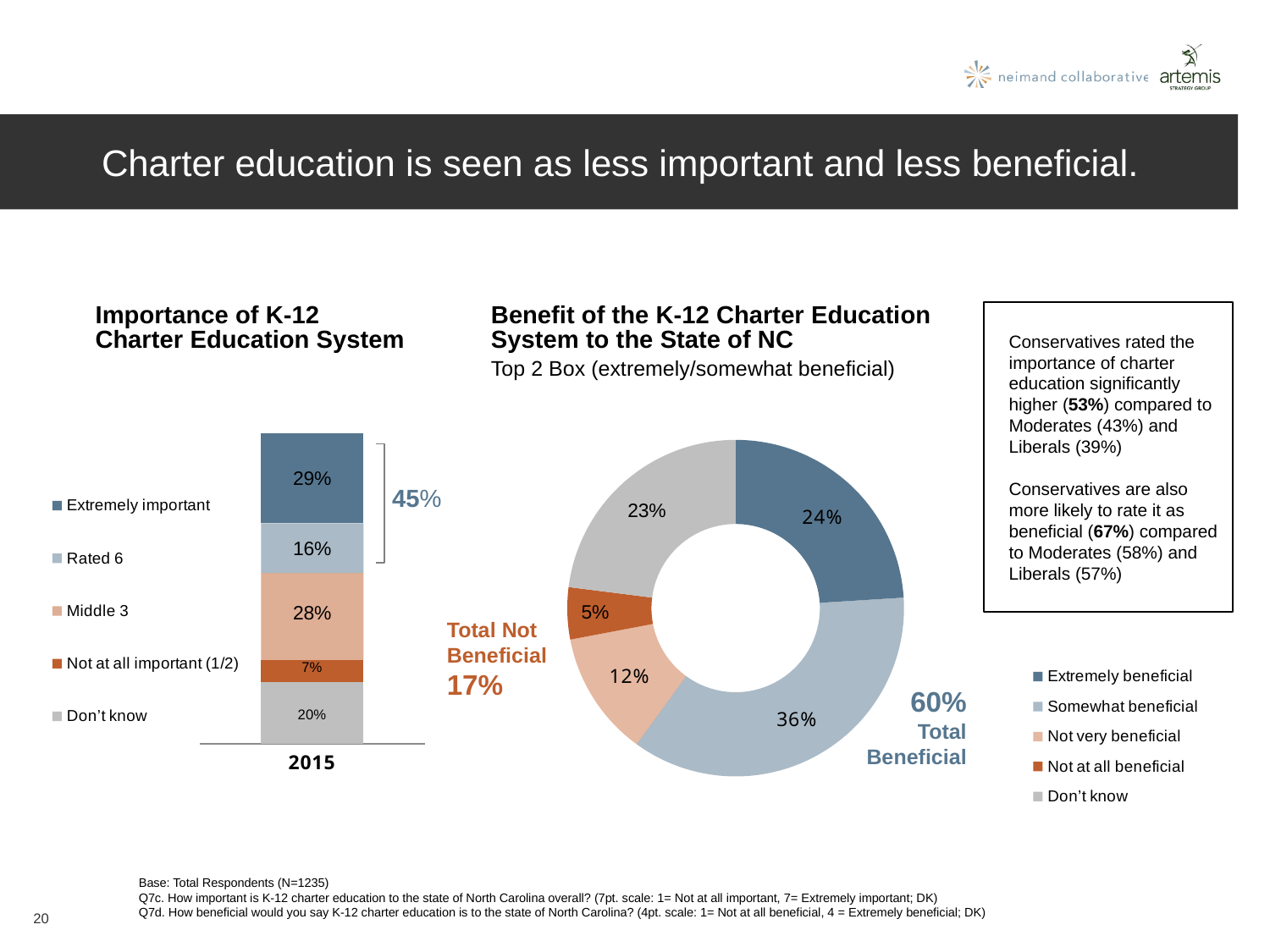
In the 'Benefit of the K-12 Charter Education System to the State of NC' chart, which is larger: the 'Extremely beneficial' share or the 'Don't know' share? Extremely beneficial In the 'Importance of K-12 Charter Education System' chart, what percentage of respondents rated charter education as extremely important in 2015? 29% What type of chart is the 'Importance of K-12 Charter Education System' chart? Stacked bar chart In the 'Importance of K-12 Charter Education System' chart, what is the difference between the 'Middle 3' share and the 'Rated 6' share? 12 percentage points What type of chart is the 'Benefit of the K-12 Charter Education System to the State of NC' chart? Donut chart In the 'Benefit of the K-12 Charter Education System to the State of NC' chart, what percentage said charter education is somewhat beneficial? 36% In the 'Benefit of the K-12 Charter Education System to the State of NC' chart, which category has the smallest share? Not at all beneficial In the 'Importance of K-12 Charter Education System' chart, how many series does the legend list? 5 In the 'Benefit of the K-12 Charter Education System to the State of NC' chart, what is the combined share of 'Not very beneficial' and 'Not at all beneficial'? 17% In the 'Importance of K-12 Charter Education System' chart, which response category has the smallest share? Not at all important (1/2) In the 'Benefit of the K-12 Charter Education System to the State of NC' chart, which category has the largest share? Somewhat beneficial In the 'Importance of K-12 Charter Education System' chart, what percentage answered 'Don't know'? 20%